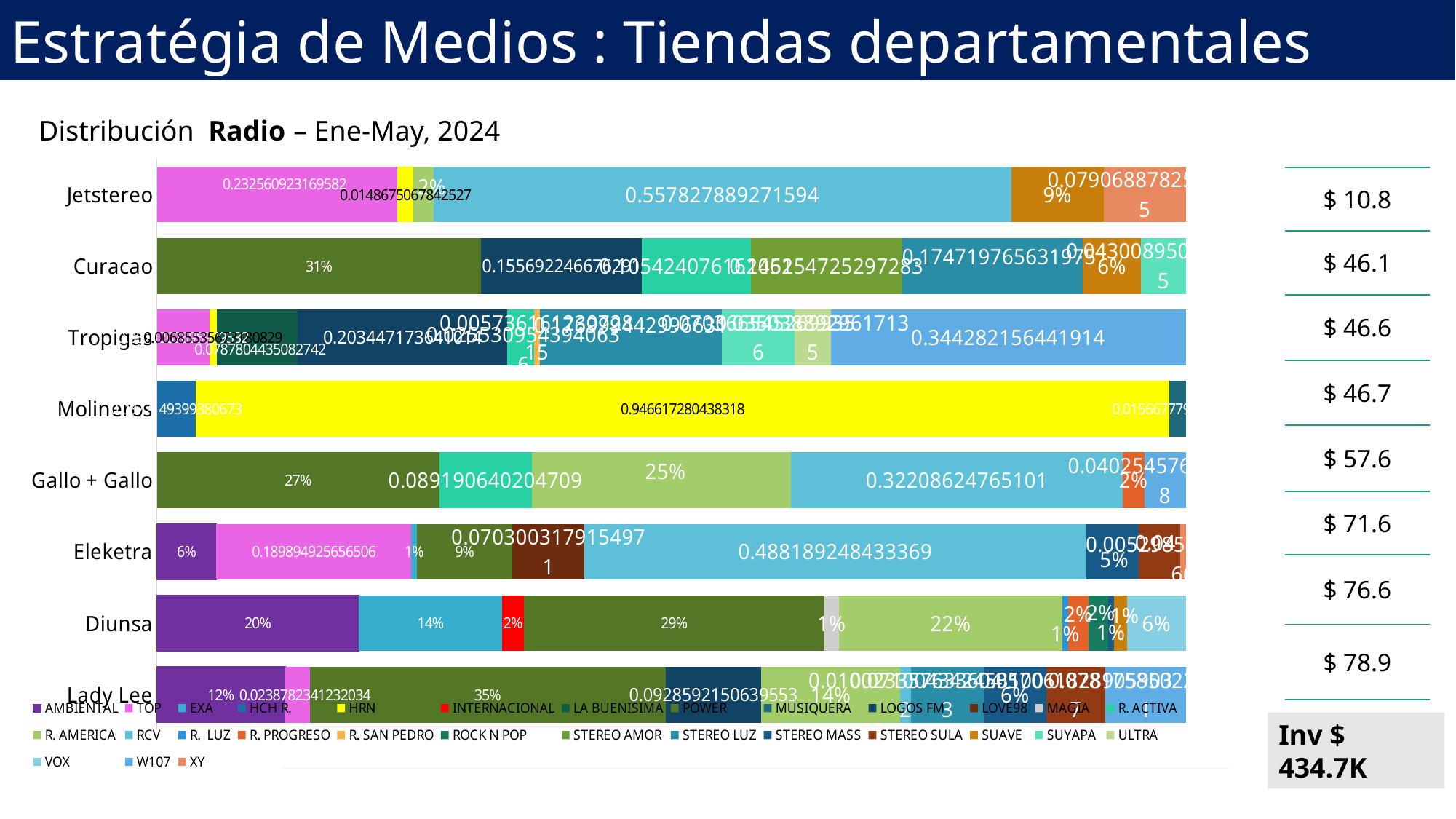
What kind of chart is shown on the slide? Stacked bar chart What is the value of the largest segment (yellow, HRN) in the Molineros bar? 0.946617280438318 What percentage is shown for the first (dark green) segment in the Curacao bar? 31% How many series does the chart legend list? 29 What is the subtitle of the chart? Distribución Radio – Ene-May, 2024 What total investment figure is shown in the box at the bottom right of the chart? Inv $ 434.7K In the Diunsa bar, what is the difference between the 29% segment and the 20% segment? 9 percentage points How many department stores (categories) are listed on the y-axis of the chart? 8 What percentage is shown for the purple (AMBIENTAL) segment in the Diunsa bar? 20% In the Diunsa bar, which is larger: the dark green segment (29%) or the light green segment (22%)? The dark green segment (29%)